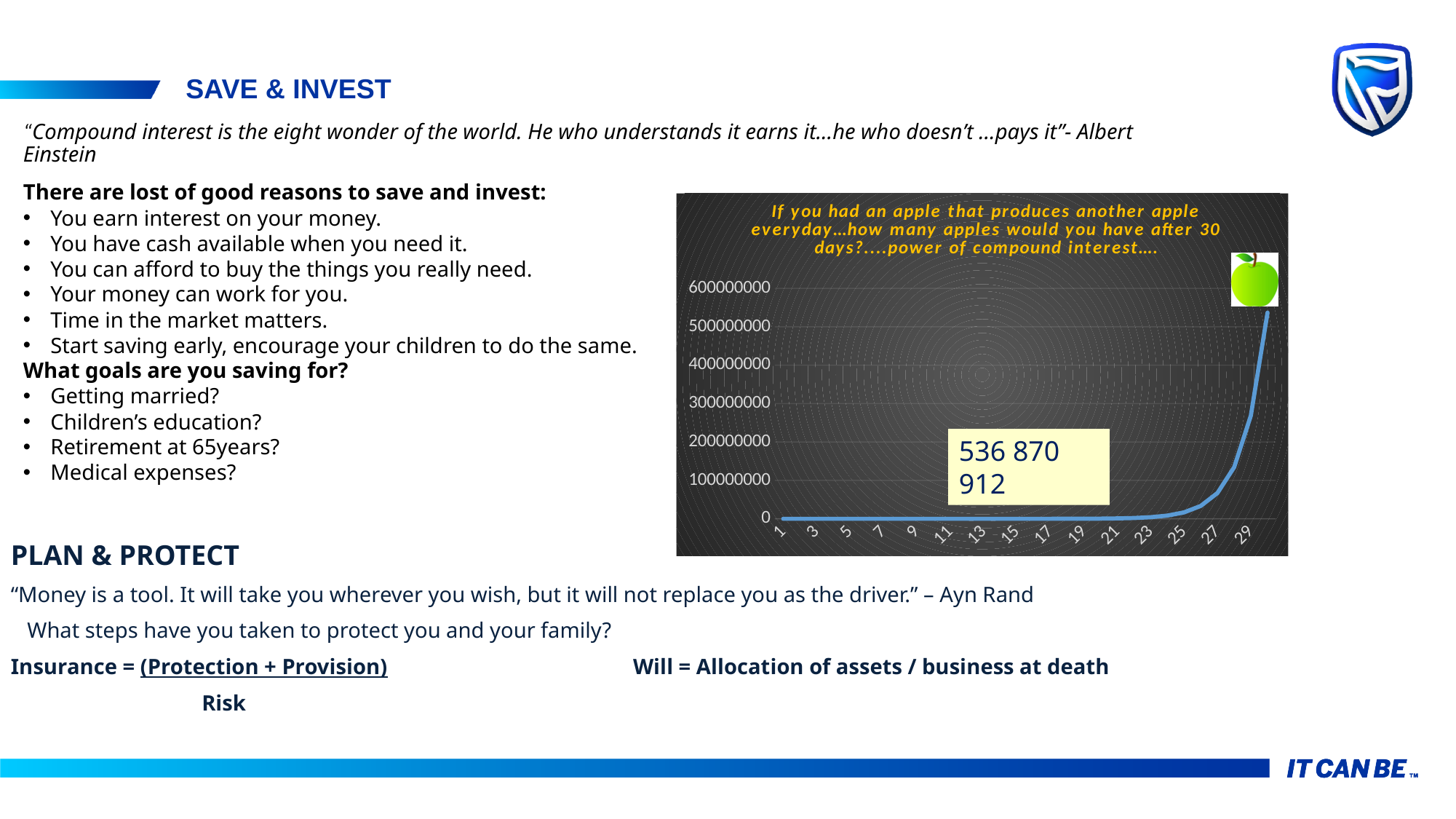
Is the value for day 15 greater or less than 100000000? less Does the highest value on the chart occur at the start or the end of the x axis? end What kind of chart is shown on the slide? line chart Is the value at the final point of the line greater or less than 500000000? greater What number is printed in the yellow box on the chart? 536 870 912 Do the values on the chart rise or fall as the day number increases along the x axis? rise Is the value for day 25 greater or less than 100000000? less Which labelled day on the x axis has the lowest value? 1 Which has the larger value, day 29 or day 1? day 29 What is the highest tick value shown on the y axis of the chart? 600000000 How many tick labels are shown on the x axis of the chart? 15